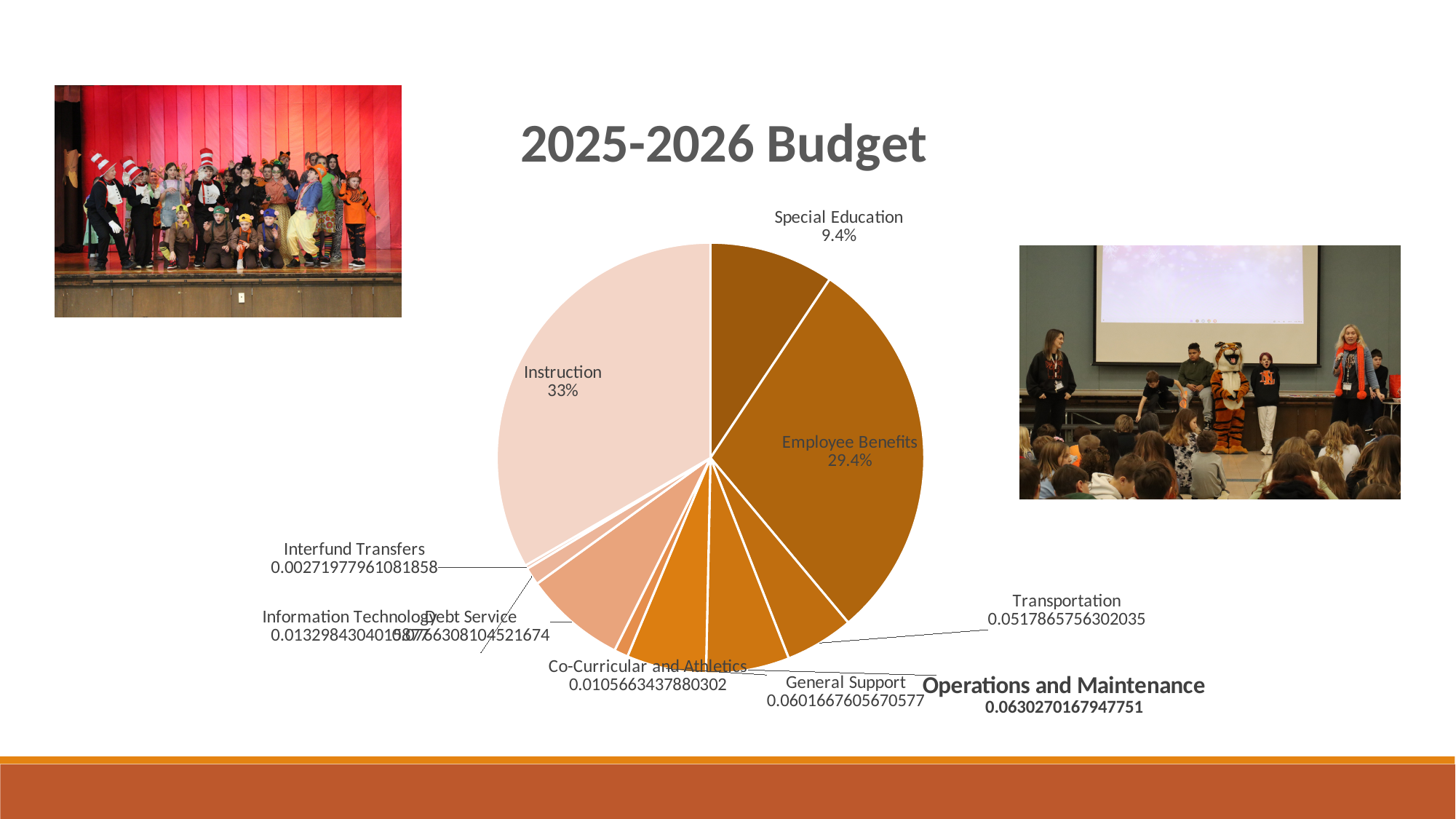
What share of the budget is Special Education? 9.4% What share of the budget is Employee Benefits? 29.4% What is the difference between the Instruction share and the Employee Benefits share? 3.6% Which category has the largest slice of the pie? Instruction How many categories are shown in the pie chart? 10 Which category has the smallest slice of the pie? Interfund Transfers What is the title of the chart? 2025-2026 Budget What value is shown for Transportation? 0.0517865756302035 Which is larger, Employee Benefits or Special Education? Employee Benefits What share of the budget is Instruction? 33% What kind of chart is shown on the slide? pie chart What value is shown for Operations and Maintenance? 0.0630270167947751